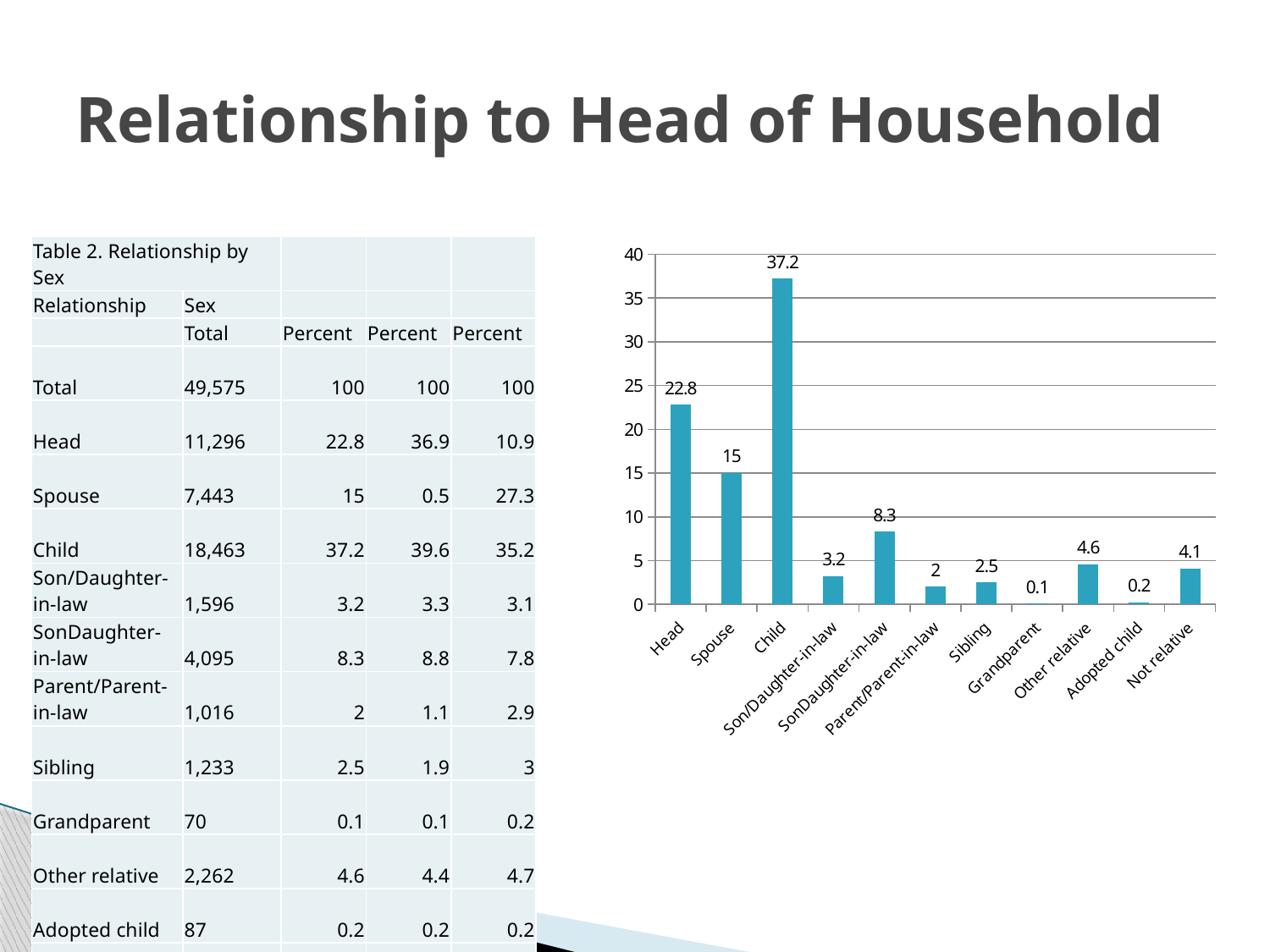
What is the value for Spouse in the chart? 15 What is the value for Adopted child in the chart? 0.2 Which category has the lowest value in the chart? Grandparent How many categories are shown on the x axis of the chart? 11 Which category has the highest value in the chart? Child What type of chart is shown on the slide? bar chart Is the value for Spouse in the chart greater or less than 20? less What is the value for Child in the chart? 37.2 What is the difference between the values for Child and Head in the chart? 14.4 Which has a larger value in the chart, Sibling or Not relative? Not relative What is the value for Other relative in the chart? 4.6 What is the value for Head in the chart? 22.8